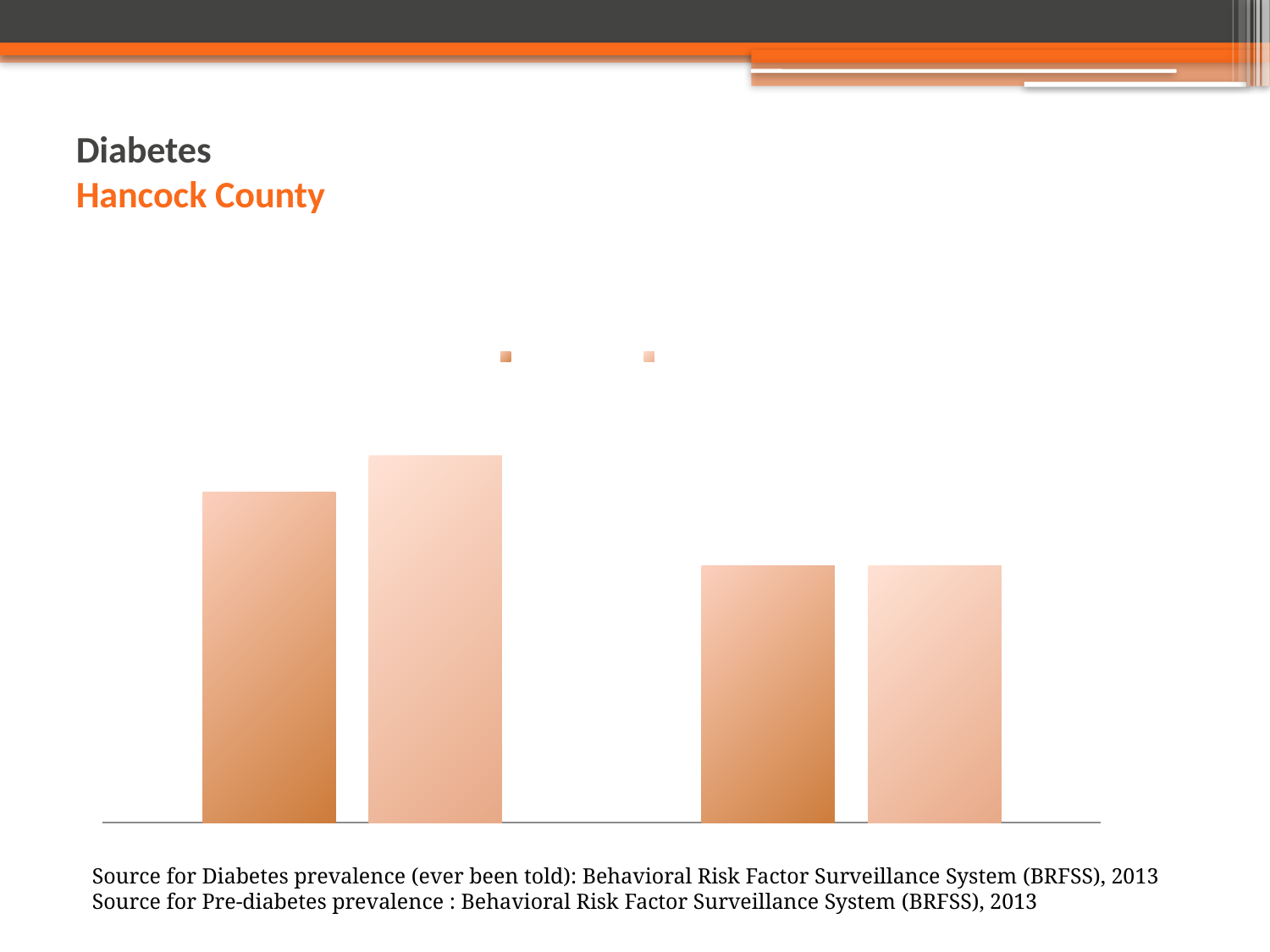
What kind of chart is shown on the slide? bar chart How many bars are plotted in the chart? 4 Which group of bars is taller, the left group or the right group? the left group How many groups of bars (categories) are plotted in the chart? 2 In the left group of bars, is the darker orange bar taller or shorter than the lighter orange bar? shorter What colours are used for the two series in the chart? dark orange and light orange How many series does the chart's legend list? 2 Do the bar heights rise or fall moving from the left group to the right group? fall